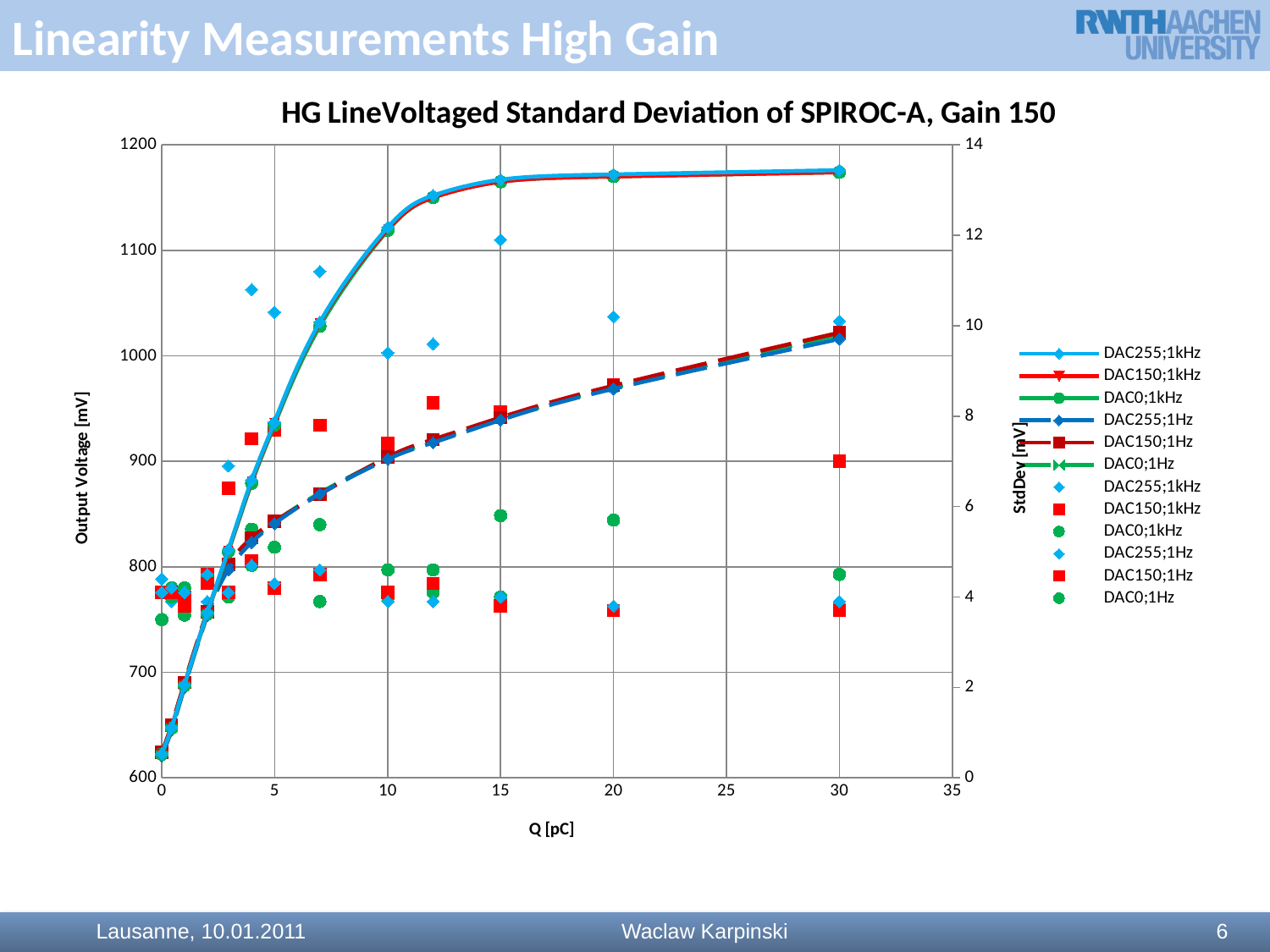
Is the output voltage of the DAC255;1kHz line at Q = 30 pC greater or less than 1100 mV? greater Is the output voltage of the DAC255;1Hz dashed line at Q = 30 pC greater or less than 1100 mV? less Is the output voltage of the DAC150;1kHz line at Q = 10 pC greater or less than 1100 mV? greater How many series does the chart's legend list? 12 Do the solid DAC255;1kHz, DAC150;1kHz and DAC0;1kHz output voltage lines rise or fall as Q increases from 0 to 30 pC? rise What is the label of the x axis? Q [pC] What kind of chart is shown on the slide? line chart What is the title of the chart? HG LineVoltaged Standard Deviation of SPIROC-A, Gain 150 At Q = 20 pC, which has the higher output voltage: the DAC255;1kHz solid line or the DAC255;1Hz dashed line? DAC255;1kHz